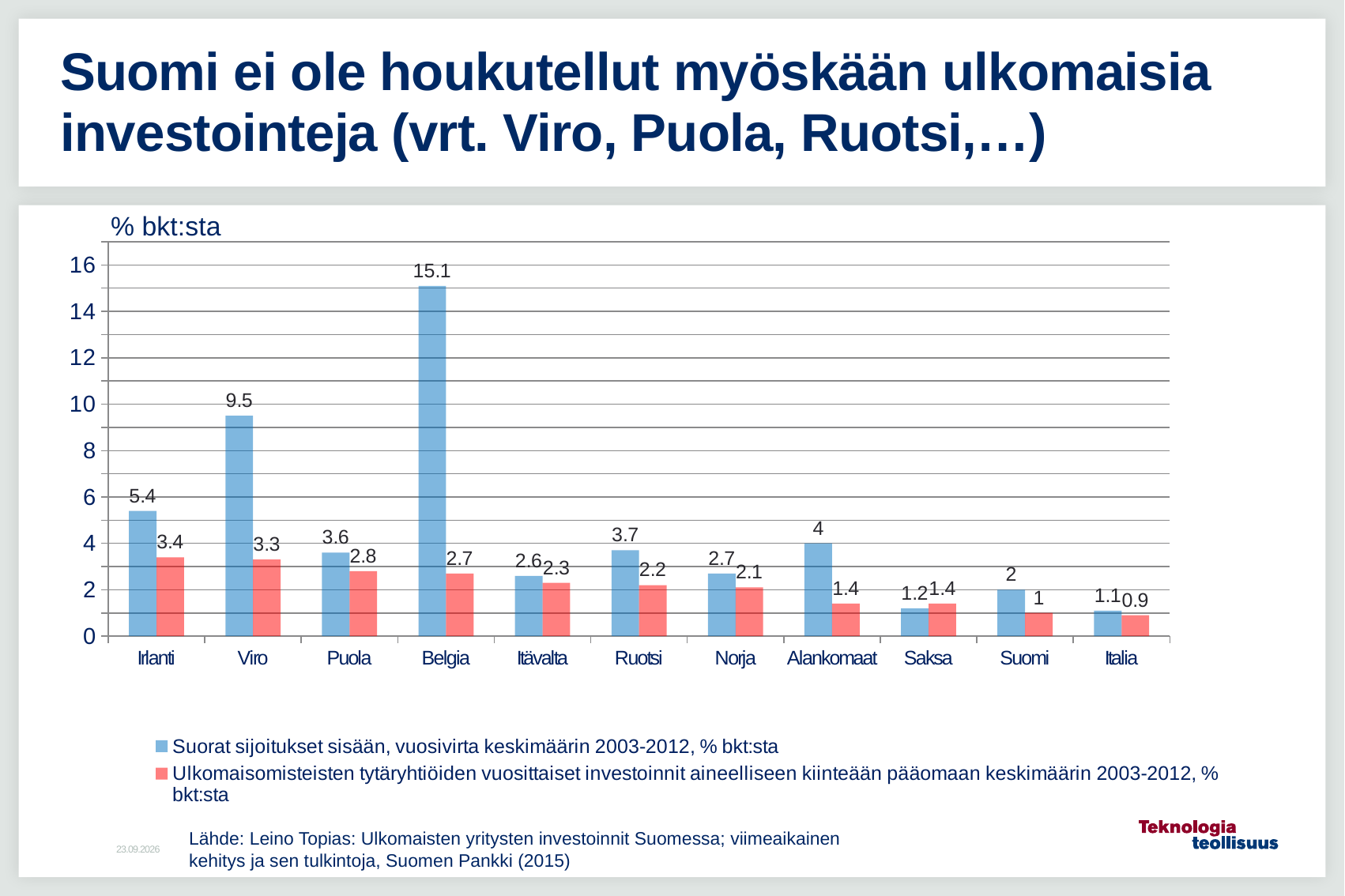
Which is larger for Saksa: the 'Suorat sijoitukset sisään' value or the 'Ulkomaisomisteisten tytäryhtiöiden vuosittaiset investoinnit' value? Ulkomaisomisteisten tytäryhtiöiden vuosittaiset investoinnit How many series does the chart's legend list? 2 What unit label is shown above the y axis of the chart? % bkt:sta What kind of chart is shown on the slide? Bar chart What is the value of 'Ulkomaisomisteisten tytäryhtiöiden vuosittaiset investoinnit aineelliseen kiinteään pääomaan keskimäärin 2003-2012, % bkt:sta' for Viro? 3.3 How many countries are shown on the x axis of the chart? 11 What is the difference between the 'Suorat sijoitukset sisään' values for Viro and Suomi? 7.5 Which country has the lowest value for 'Ulkomaisomisteisten tytäryhtiöiden vuosittaiset investoinnit aineelliseen kiinteään pääomaan keskimäärin 2003-2012, % bkt:sta'? Italia What is the value of 'Suorat sijoitukset sisään, vuosivirta keskimäärin 2003-2012, % bkt:sta' for Belgia? 15.1 What is the value of 'Suorat sijoitukset sisään, vuosivirta keskimäärin 2003-2012, % bkt:sta' for Suomi? 2 Which country has the highest value for 'Suorat sijoitukset sisään, vuosivirta keskimäärin 2003-2012, % bkt:sta'? Belgia Is the 'Suorat sijoitukset sisään' value for Viro greater or less than 8? greater